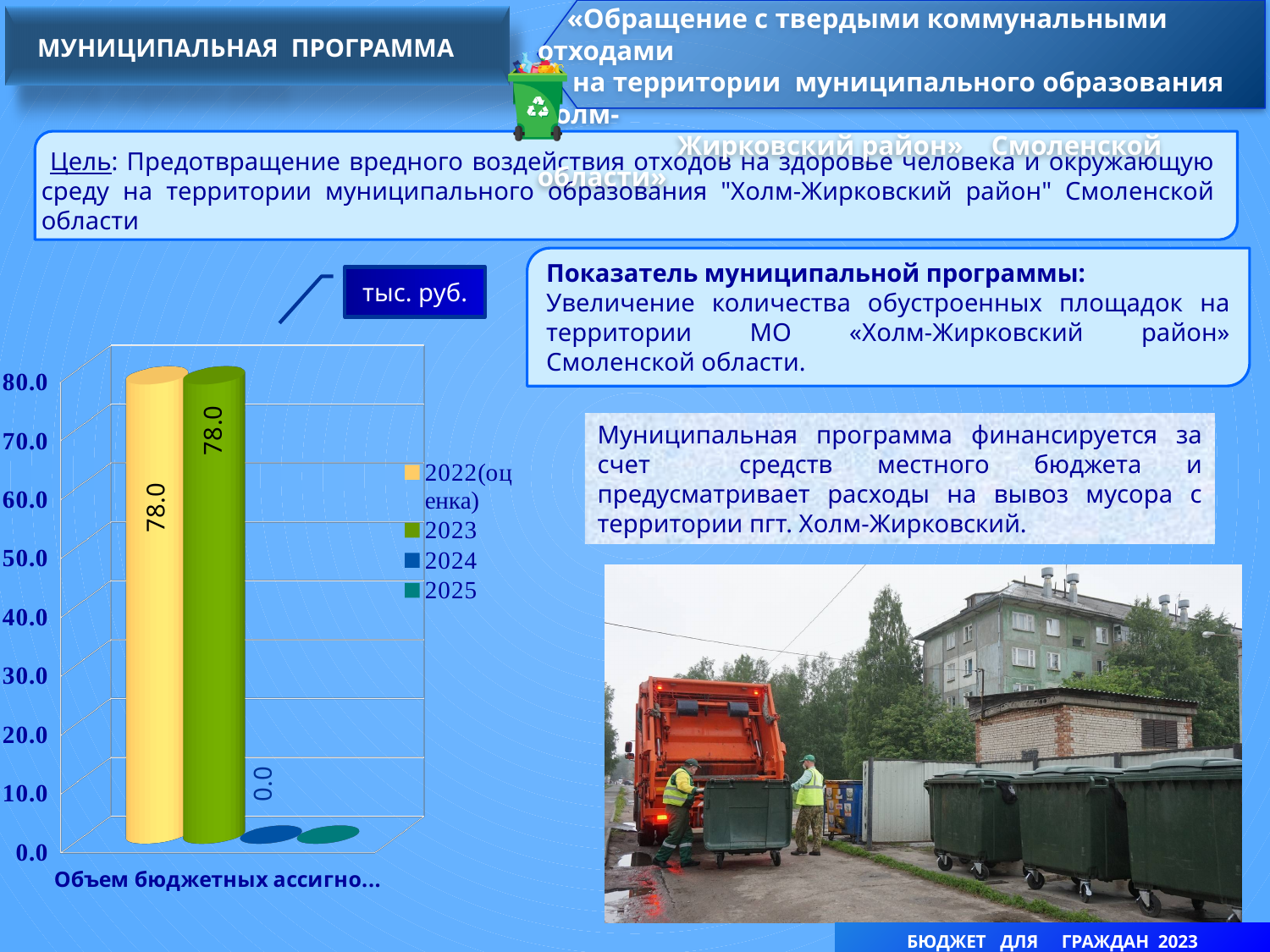
Which is larger, the value for 2023 or the value for 2024? 2023 How many series does the chart legend list? 4 What is the highest value shown on the vertical axis of the chart? 80.0 Is the value for 2024 greater or less than 10.0? less What unit is indicated for the chart values? тыс. руб. What kind of chart is shown on the slide? bar chart What is the value for 2022(оценка) in the chart? 78.0 What is the difference between the values for 2022(оценка) and 2023? 0.0 What colour represents 2023 in the chart legend? green What is the value for 2023 in the chart? 78.0 Is the value for 2023 greater or less than 70.0? greater